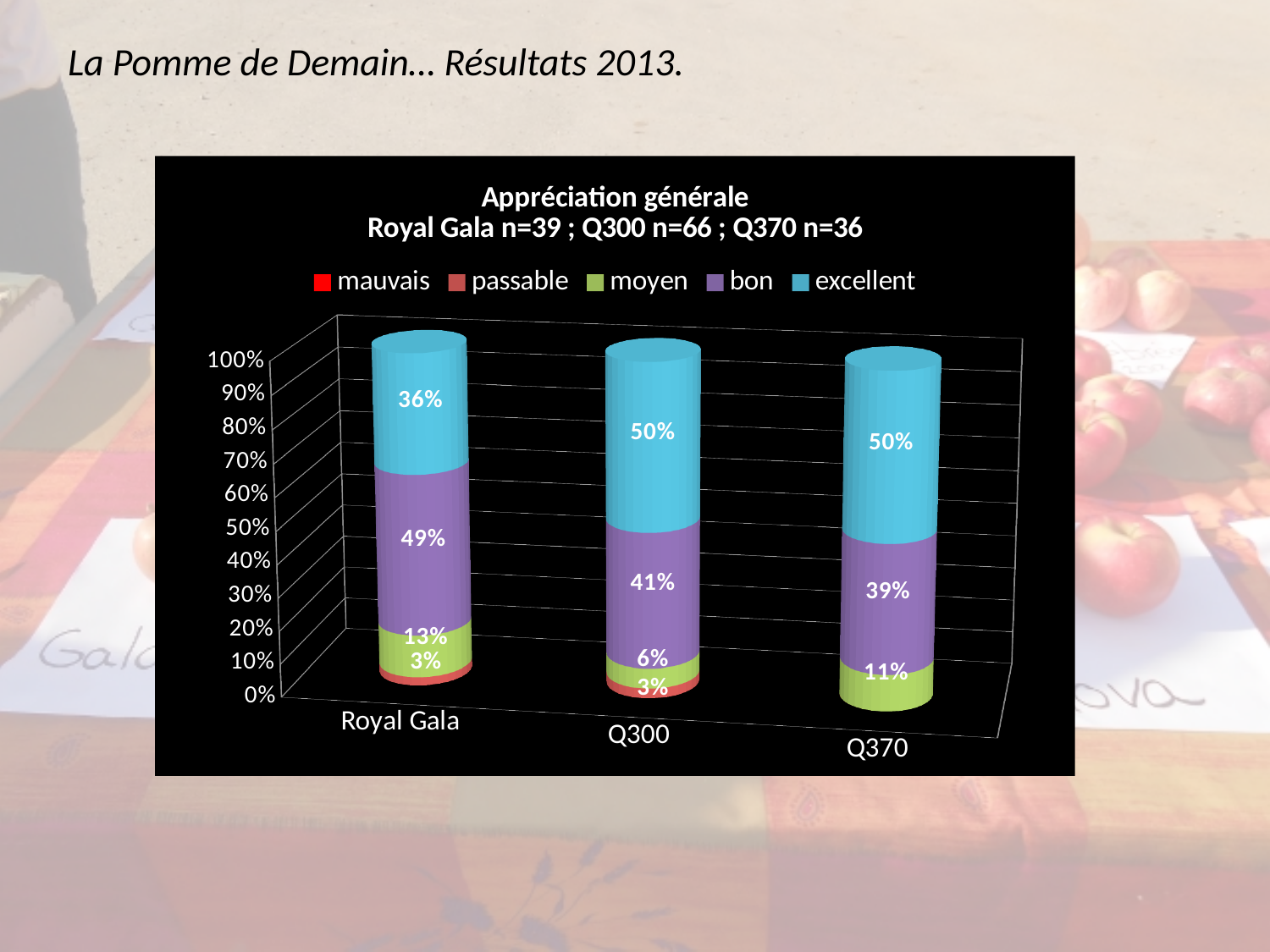
What is the 'bon' share for Q300? 41% What is the 'bon' share for Q370? 39% What is the 'moyen' share for Q370? 11% What is the difference between the 'bon' share for Royal Gala and for Q370? 10% What kind of chart is shown on the slide? Stacked bar chart What is the first line of the chart title? Appréciation générale Which variety has the highest 'bon' share? Royal Gala Which variety has the lowest 'excellent' share? Royal Gala Which has the larger 'moyen' share, Royal Gala or Q300? Royal Gala How many apple varieties (categories) are plotted on the x axis? 3 How many series does the legend list? 5 What is the 'excellent' share for Royal Gala? 36%